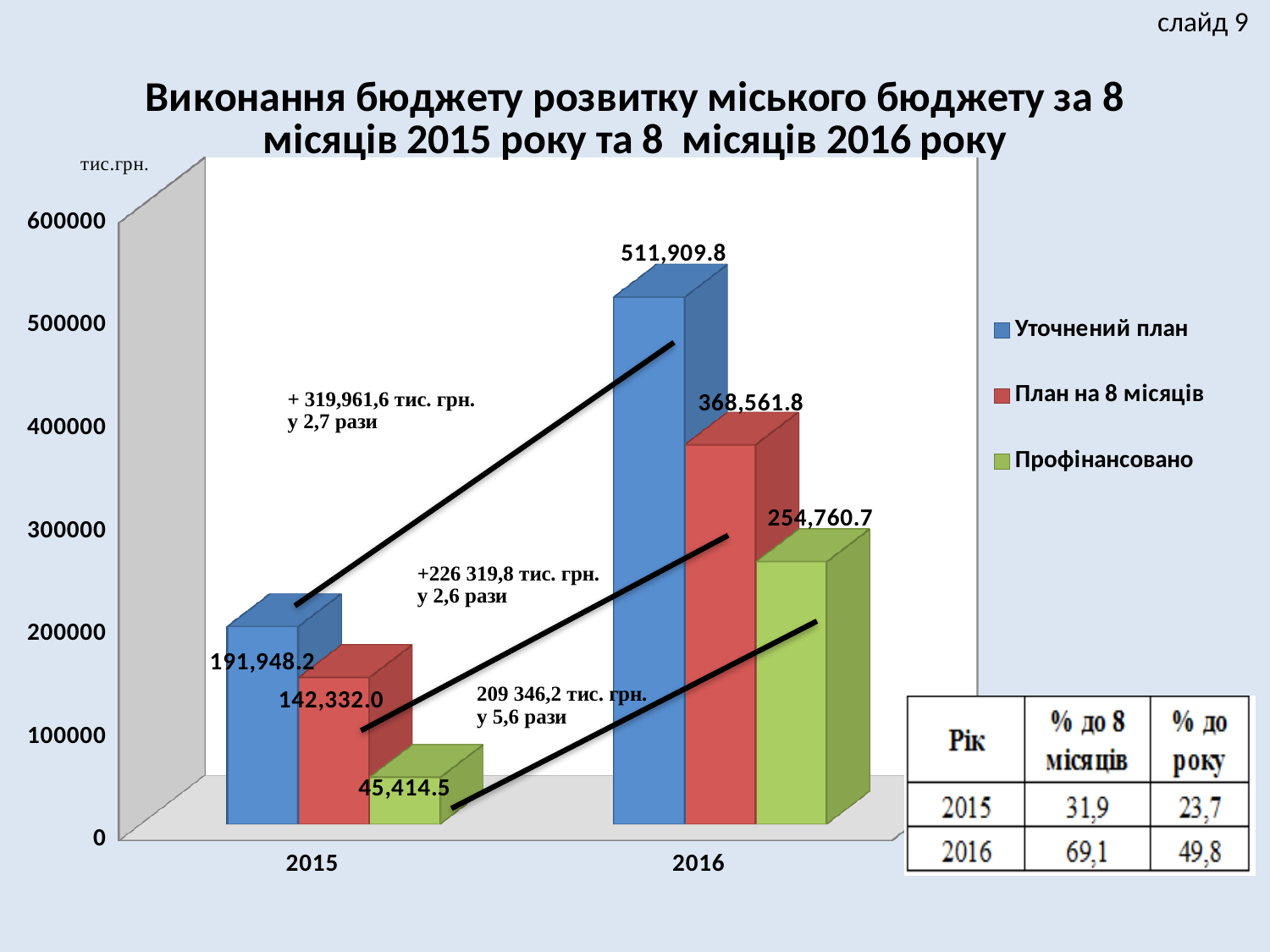
What is the value of Профінансовано for 2015? 45,414.5 Which series has the lowest value in 2015? Профінансовано Which series has the highest value in 2016? Уточнений план What is the value of План на 8 місяців for 2016? 368,561.8 How many years are shown on the x axis of the chart? 2 What kind of chart is shown on the slide? Bar chart Which is larger: План на 8 місяців in 2015 or Профінансовано in 2016? Профінансовано in 2016 What is the difference between Профінансовано in 2016 and Профінансовано in 2015? 209,346.2 How many series does the legend list? 3 What is the value of Уточнений план for 2016? 511,909.8 Is the value of Уточнений план for 2016 greater or less than 500000? greater What is the value of Уточнений план for 2015? 191,948.2